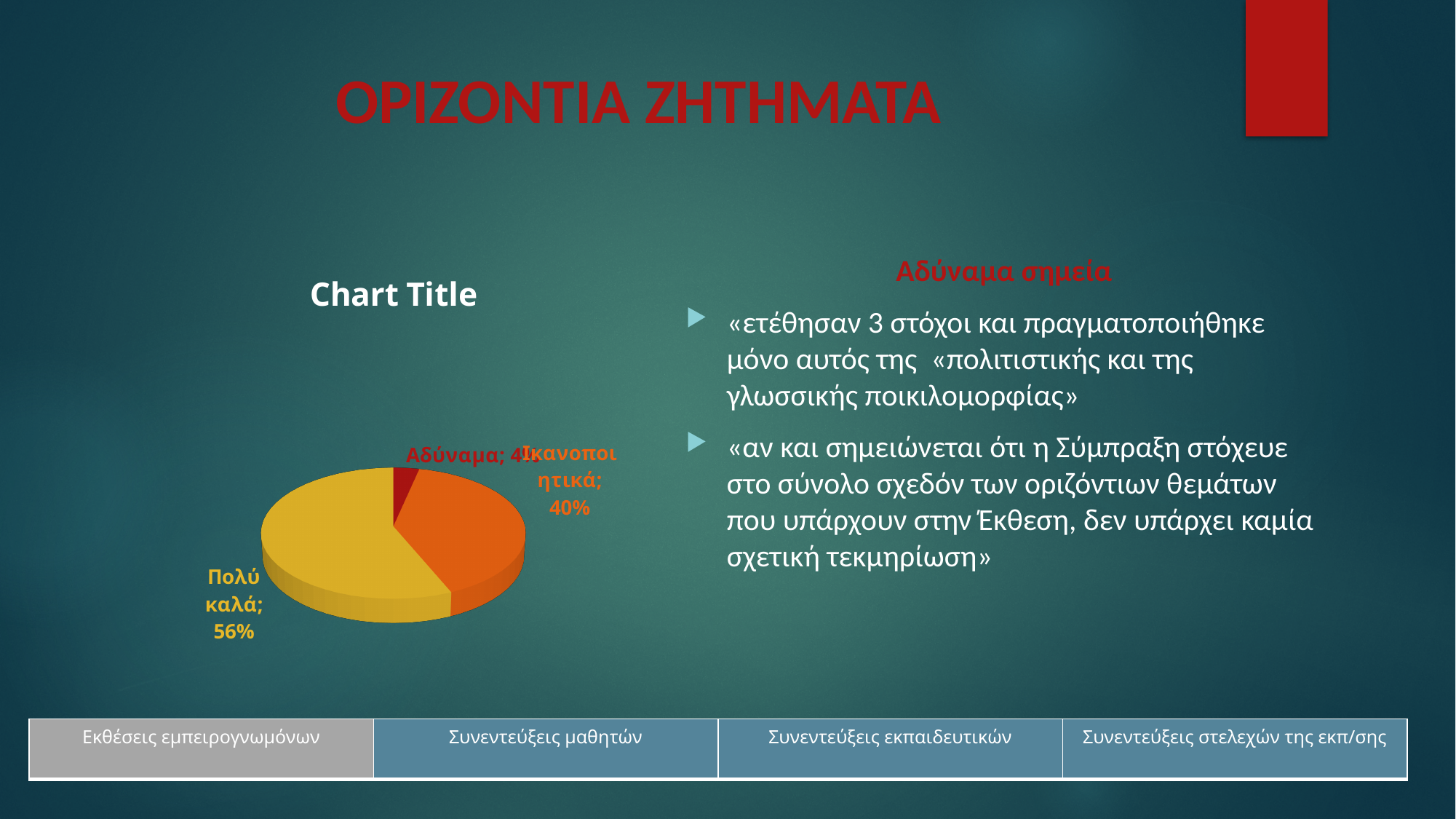
What colour is the 'Πολύ καλά' slice of the pie chart? yellow How many slices does the pie chart have? 3 Is the share for 'Πολύ καλά' greater or less than 50%? greater Which category has the largest share of the pie? Πολύ καλά What is the title shown above the pie chart? Chart Title Which is larger, the share for 'Πολύ καλά' or for 'Ικανοποιητικά'? Πολύ καλά What percentage is shown for the 'Ικανοποιητικά' slice? 40% What percentage is shown for the 'Αδύναμα' slice? 4% What percentage is shown for the 'Πολύ καλά' slice? 56% Which category has the smallest share of the pie? Αδύναμα What kind of chart is shown on the slide? pie chart What is the difference in percentage points between 'Πολύ καλά' and 'Ικανοποιητικά'? 16 percentage points